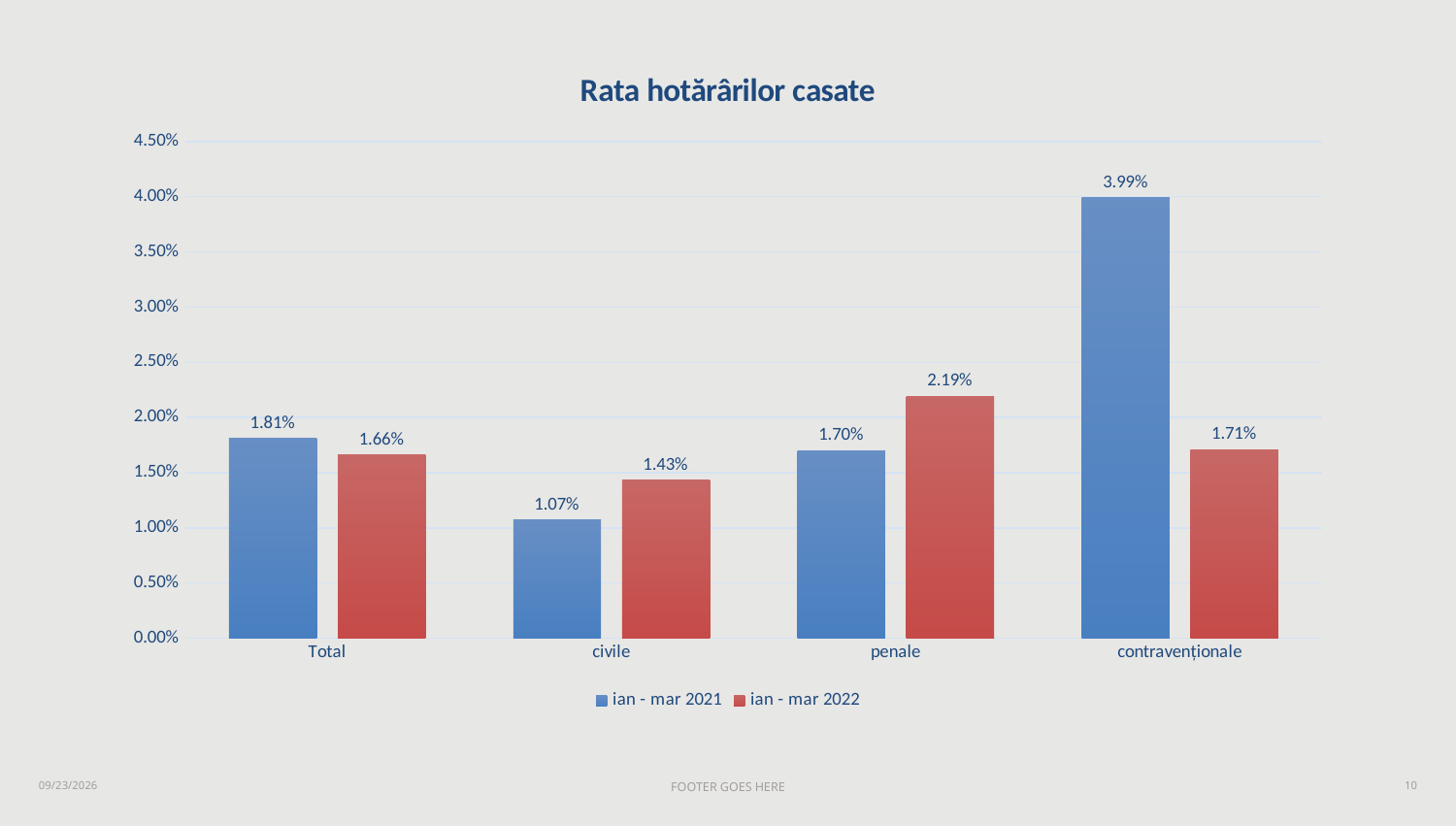
What is the value for civile in the ian - mar 2022 series? 1.43% What is the Total value for ian - mar 2022? 1.66% What is the value for penale in the ian - mar 2021 series? 1.70% What is the value for contravenționale in the ian - mar 2021 series? 3.99% How many series does the legend list? 2 Which category has the lowest value in the ian - mar 2022 series? civile What is the difference between the ian - mar 2021 and ian - mar 2022 values for contravenționale? 2.28% What kind of chart is shown on the slide? bar chart Which is larger for penale: the ian - mar 2021 value or the ian - mar 2022 value? ian - mar 2022 How many categories are shown on the x axis? 4 Which category has the highest value in the ian - mar 2021 series? contravenționale What is the title of the chart? Rata hotărârilor casate